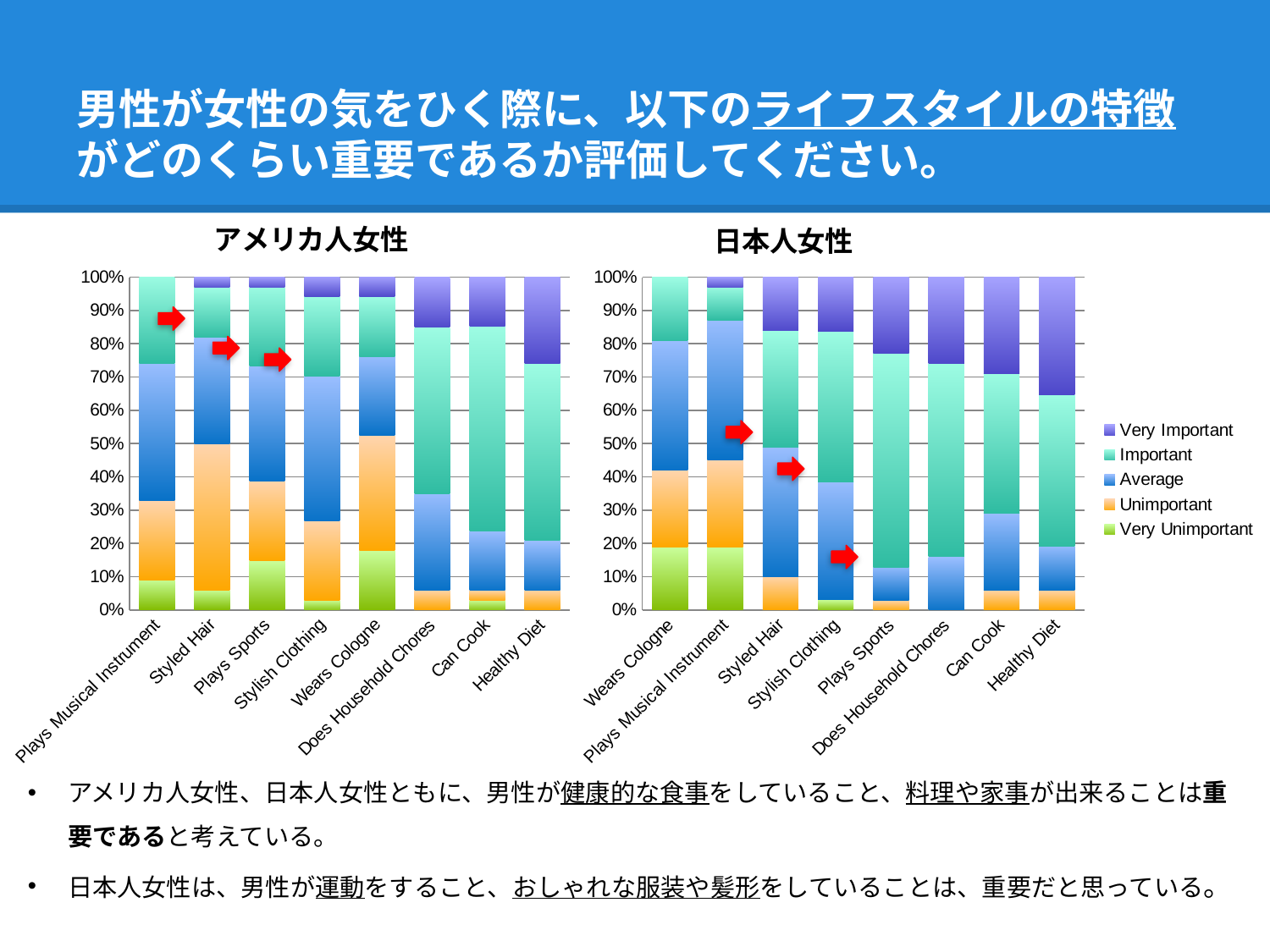
In the アメリカ人女性 chart, is the Important value for Can Cook greater or less than 50%? greater In the アメリカ人女性 chart, is the Very Unimportant value for Wears Cologne greater or less than 10%? greater How many categories are shown on the 日本人女性 chart? 8 In the 日本人女性 chart, is the Very Important value for Plays Musical Instrument greater or less than 10%? less In the アメリカ人女性 chart, which category has the largest Very Important segment? Healthy Diet What is the total of the stacked bar for Healthy Diet in the 日本人女性 chart? 100% What kind of chart is the アメリカ人女性 chart? Stacked bar chart In the 日本人女性 chart, which is larger, the Very Unimportant value for Wears Cologne or for Healthy Diet? Wears Cologne How many series does the legend list? 5